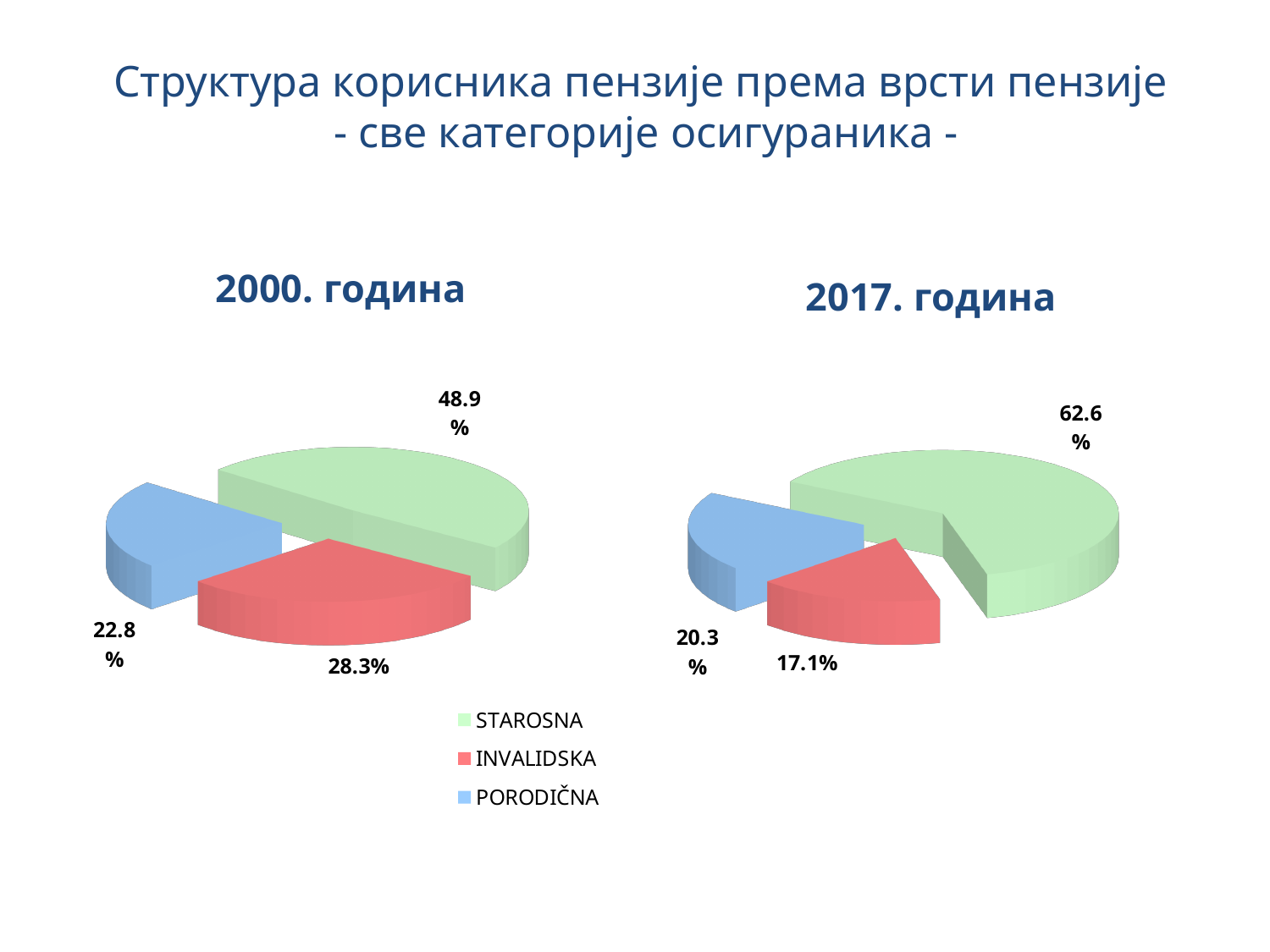
What type of chart is used on this slide? Pie chart In the 2017. година chart, which category has the smallest share? INVALIDSKA In the 2000. година chart, what is the share for INVALIDSKA? 28.3% In the 2000. година chart, which is larger: INVALIDSKA or PORODIČNA? INVALIDSKA In the 2000. година chart, what is the share for STAROSNA? 48.9% In the 2017. година chart, which category has the largest share? STAROSNA In the 2000. година chart, which category has the smallest share? PORODIČNA In the 2017. година chart, what is the share for STAROSNA? 62.6% In the 2000. година chart, what is the share for PORODIČNA? 22.8% In the 2017. година chart, what is the share for INVALIDSKA? 17.1% In the 2017. година chart, what is the share for PORODIČNA? 20.3% What is the difference between the STAROSNA share in the 2017. година chart and in the 2000. година chart? 13.7%